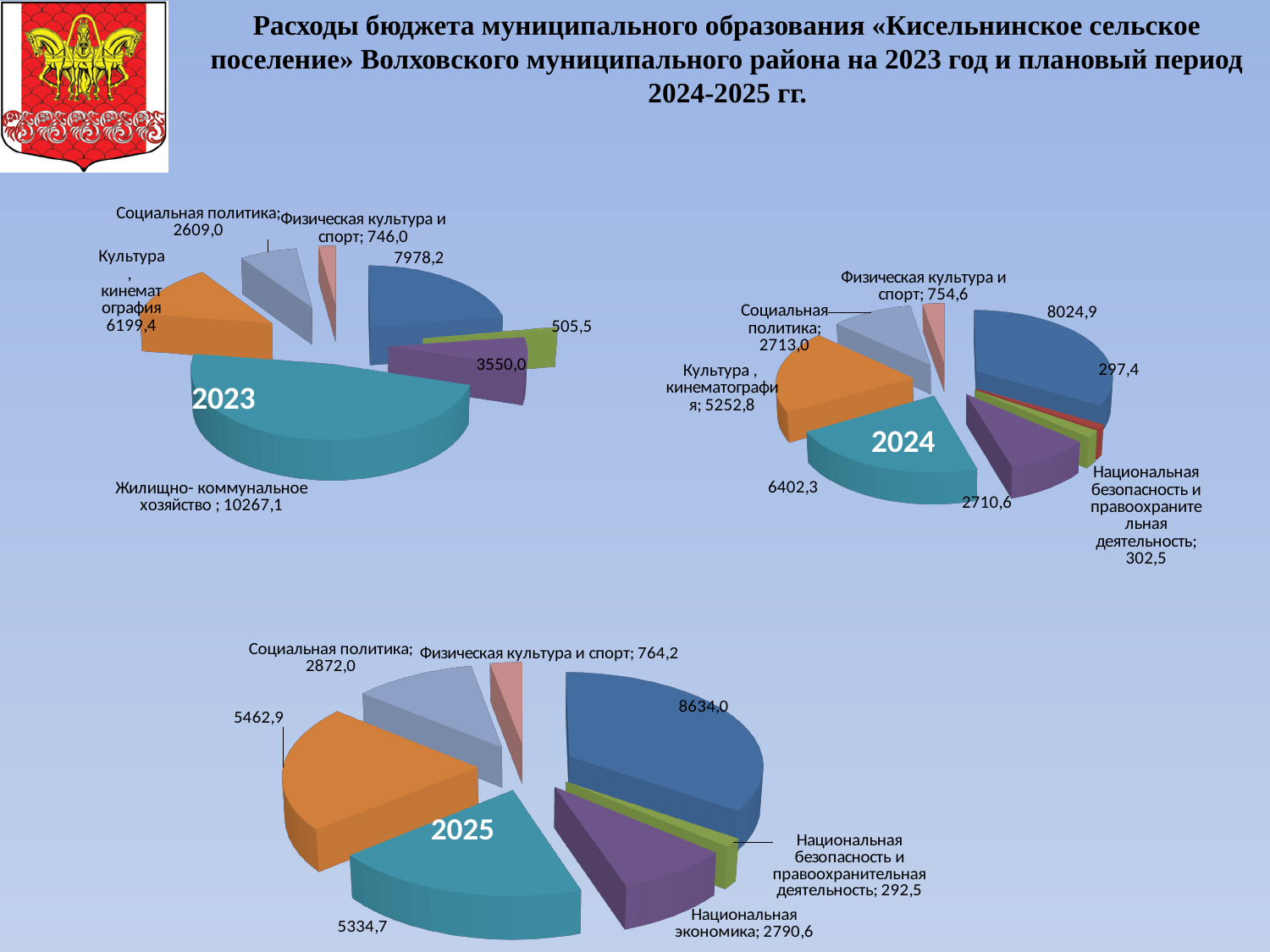
In the 2025 pie chart, what is the largest value shown? 8634,0 In the 2024 pie chart, what is the smallest value shown? 297,4 In the 2023 pie chart, what is the value for Социальная политика? 2609,0 In the 2023 pie chart, which category has the largest value? Жилищно-коммунальное хозяйство In the 2023 pie chart, what is the value for Культура, кинематография? 6199,4 In the 2024 pie chart, what is the value for Физическая культура и спорт? 754,6 In the 2024 pie chart, what is the value for Национальная безопасность и правоохранительная деятельность? 302,5 In the 2023 pie chart, what is the value for Жилищно-коммунальное хозяйство? 10267,1 In the 2023 pie chart, which is larger: Культура, кинематография or Социальная политика? Культура, кинематография What type of chart is used for the 2025 data? Pie chart In the 2025 pie chart, what is the value for Национальная экономика? 2790,6 In the 2025 pie chart, what is the difference between Социальная политика and Физическая культура и спорт? 2107,8